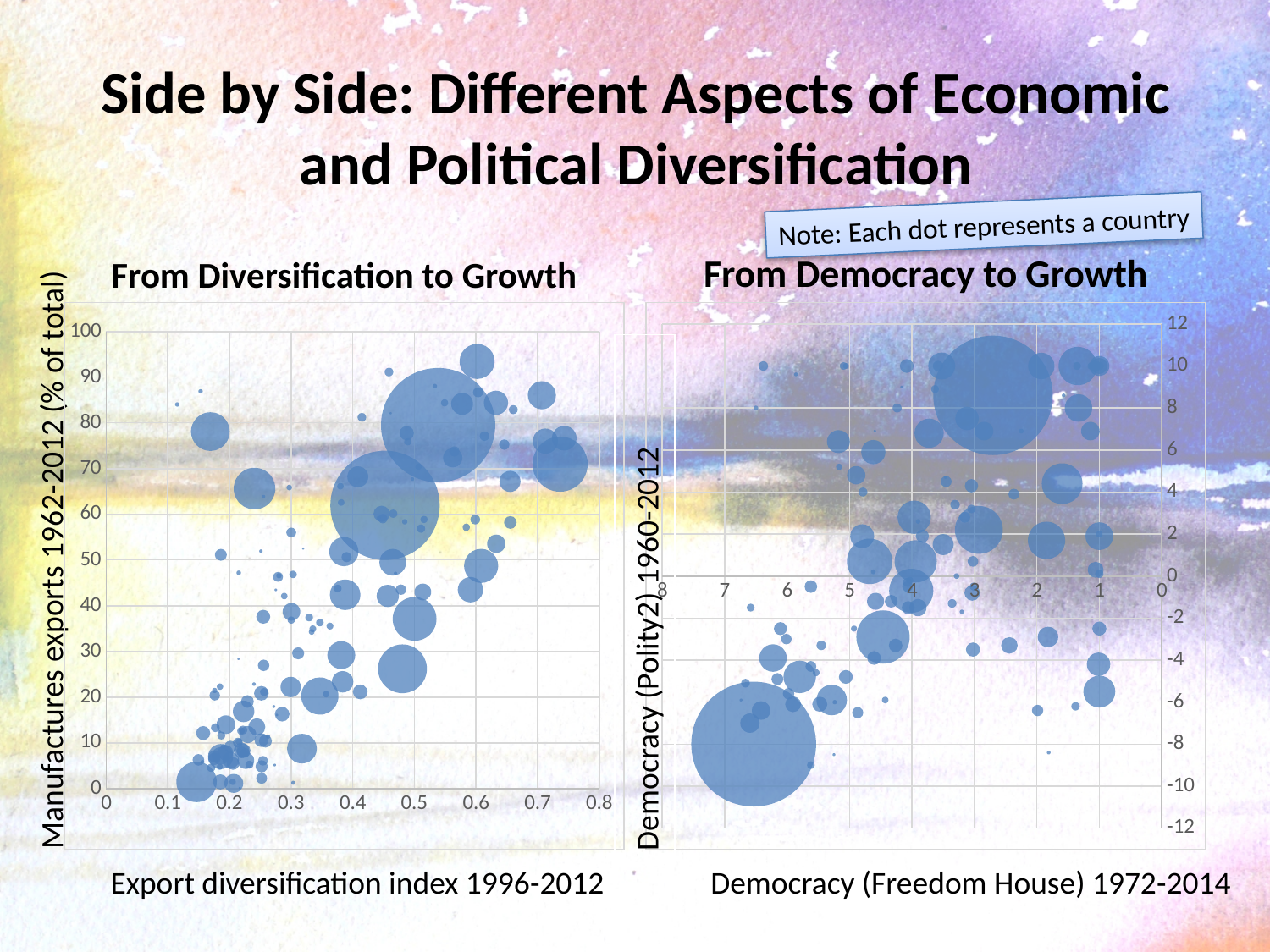
In the left chart 'From Diversification to Growth', do the manufactures exports values generally rise or fall as the export diversification index increases along the x axis? Rise What is the y-axis label of the right chart 'From Democracy to Growth'? Democracy (Polity2) 1960-2012 What kind of chart is the left chart titled 'From Diversification to Growth'? Bubble chart In the right chart 'From Democracy to Growth', do the Polity2 values generally rise or fall moving from left to right along the x axis? Rise What is the x-axis label of the left chart 'From Diversification to Growth'? Export diversification index 1996-2012 What kind of chart is the right chart titled 'From Democracy to Growth'? Bubble chart In the right chart 'From Democracy to Growth', is the largest bubble's value on the y axis greater or less than 0? less